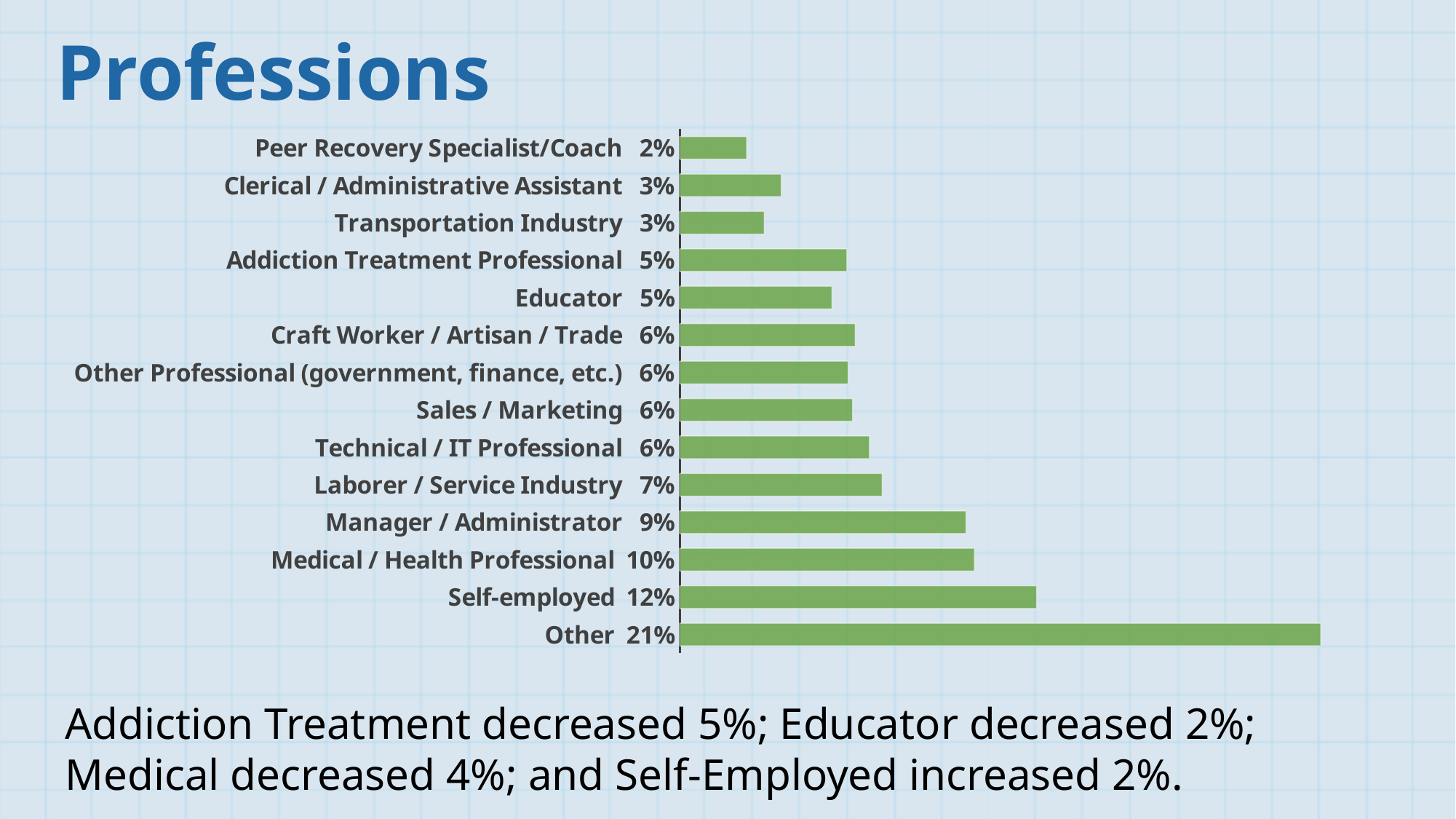
How many categories are shown in the chart? 14 Which category has the lowest percentage? Peer Recovery Specialist/Coach What is the title of the slide? Professions What kind of chart is shown on the slide? Bar chart What percentage is shown for Laborer / Service Industry? 7% What percentage is shown for Peer Recovery Specialist/Coach? 2% What is the difference between the percentages for Manager / Administrator and Educator? 4% What percentage is shown for Medical / Health Professional? 10% What is the difference between the percentages for Other and Self-employed? 9% Which is larger, the percentage for Medical / Health Professional or for Manager / Administrator? Medical / Health Professional Which category has the highest percentage? Other What percentage is shown for Self-employed? 12%